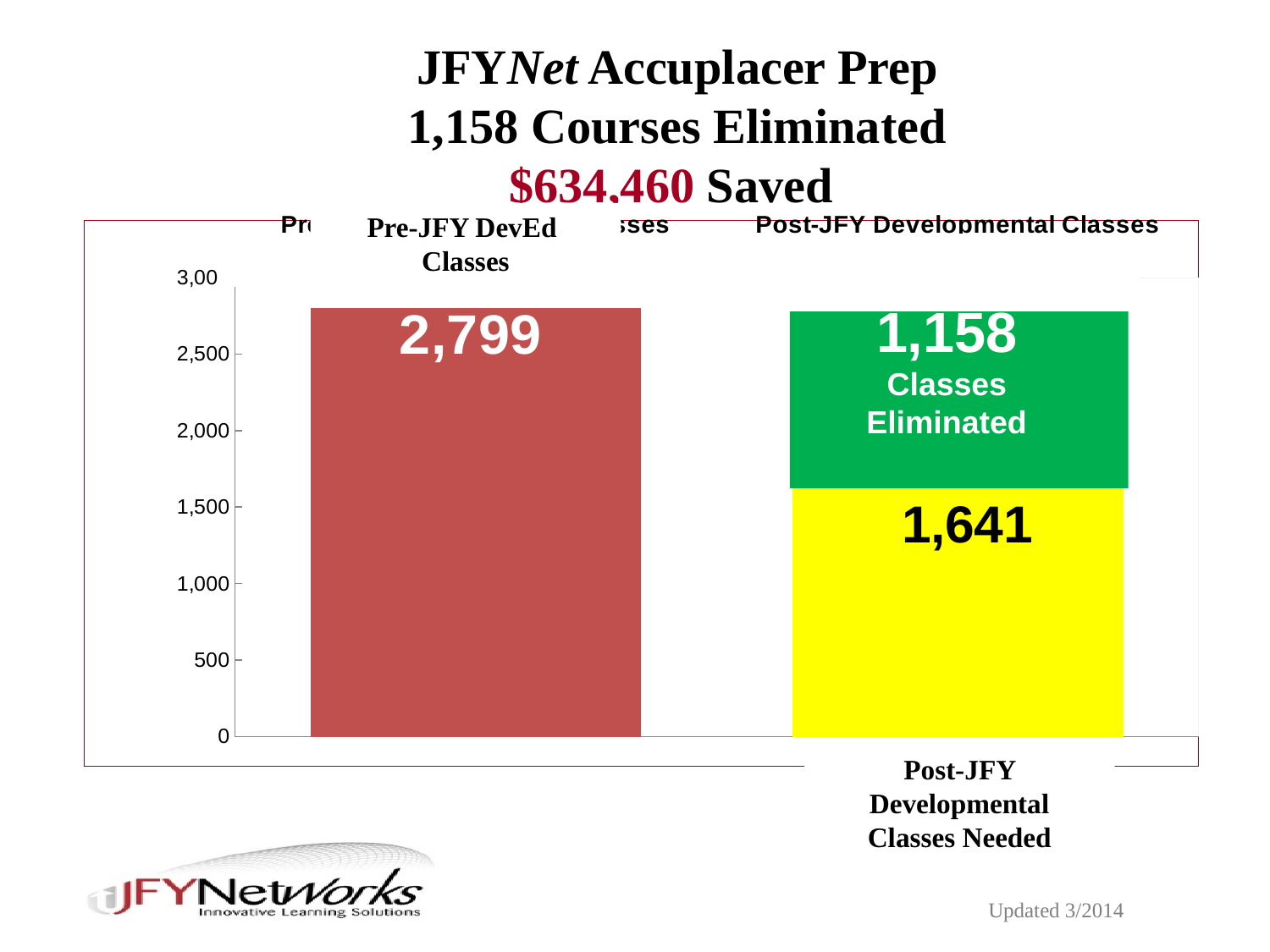
How many bars are plotted in the chart? 2 Is the Post-JFY Developmental Classes Needed value greater or less than 2,000? less What is the total of the stacked Post-JFY Developmental Classes bar (classes needed plus classes eliminated)? 2,799 Is the Pre-JFY DevEd Classes value greater or less than 2,500? greater What colour is the segment representing the 1,158 classes eliminated? green How many classes were eliminated according to the green segment of the Post-JFY bar? 1,158 According to the slide title, how much money was saved? $634,460 Which is larger, the Pre-JFY DevEd Classes value or the Post-JFY Developmental Classes Needed value? Pre-JFY DevEd Classes What is the difference between the Pre-JFY DevEd Classes value and the Post-JFY Developmental Classes Needed value? 1,158 What is the value of the Pre-JFY DevEd Classes bar? 2,799 How many Post-JFY Developmental Classes are needed according to the yellow segment? 1,641 What kind of chart is shown on the slide? bar chart